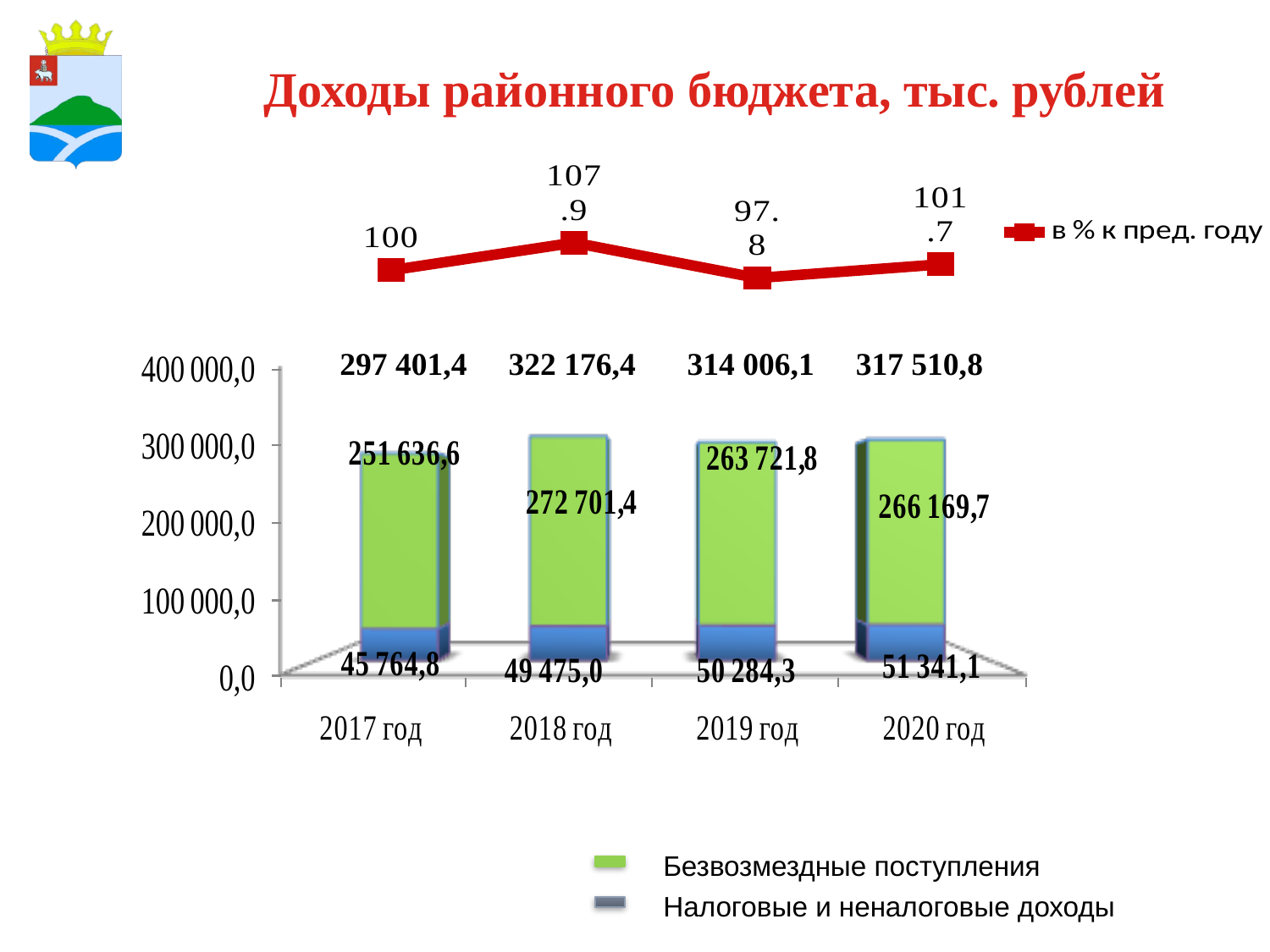
What is the value of the line 'в % к пред. году' for 2019 год? 97.8 How many years are shown on the x axis? 4 What is the difference between Налоговые и неналоговые доходы in 2020 год and 2017 год? 5 576,3 Which is larger: Безвозмездные поступления in 2019 год or in 2020 год? 2020 год What kind of chart shows the budget income by year? Stacked bar chart What is the value of Налоговые и неналоговые доходы for 2020 год? 51 341,1 What is the value of Безвозмездные поступления for 2018 год? 272 701,4 Which year has the highest value of Налоговые и неналоговые доходы? 2020 год Which year has the lowest total budget income? 2017 год What is the total district budget income shown above the bar for 2019 год? 314 006,1 How many series does the bar chart legend list? 2 Which year has the highest value on the line 'в % к пред. году'? 2018 год